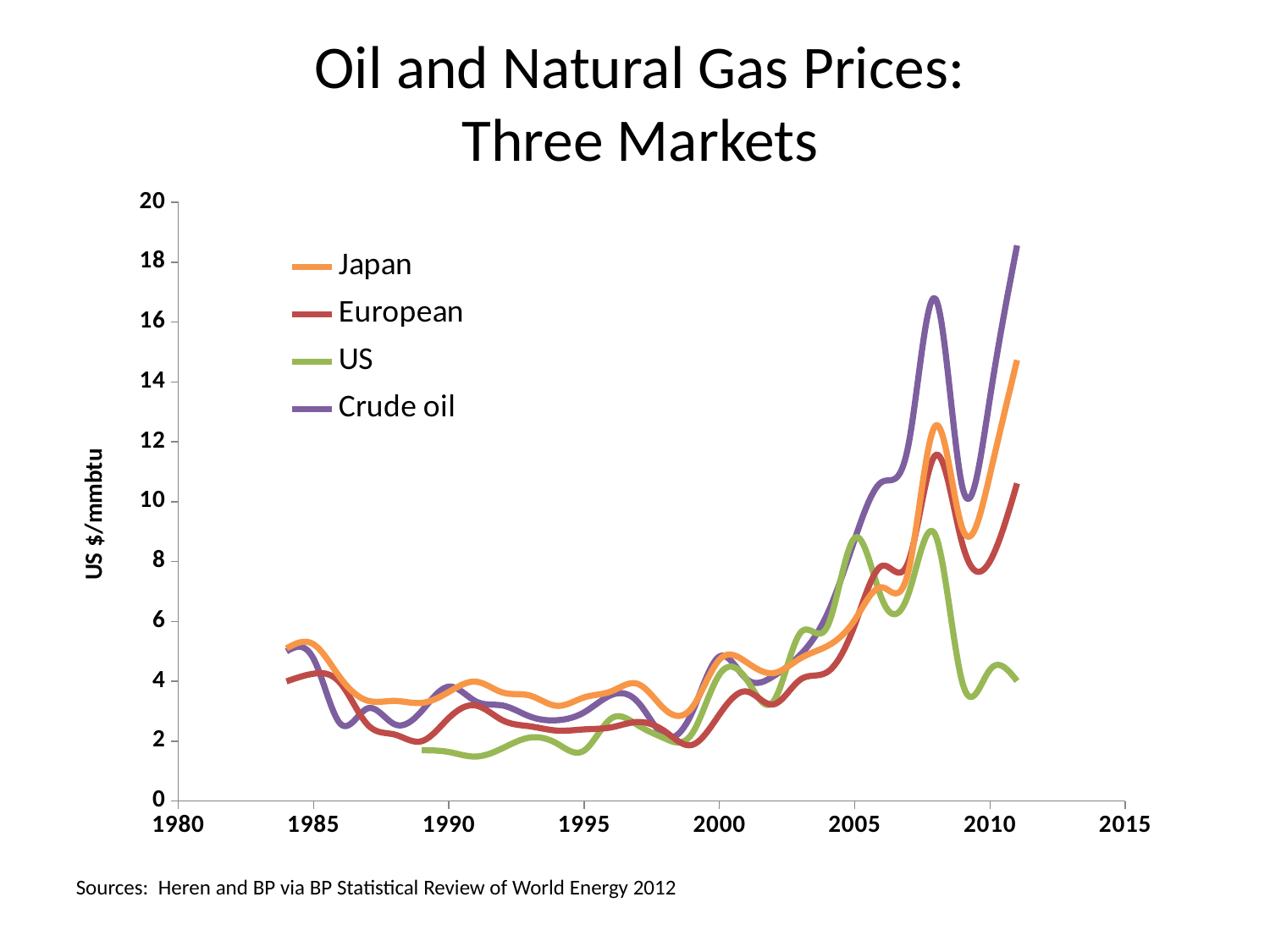
What is the title of the chart? Oil and Natural Gas Prices: Three Markets Is the value for Crude oil in 2011 greater or less than 16? greater What kind of chart is shown on the slide? line chart How many series does the legend list? 4 Is the value for US in 2011 greater or less than 6? less Does the Crude oil series rise or fall between 2009 and 2011? rise Which series has the lowest value at the right end of the chart (2011)? US What is the label on the vertical axis? US $/mmbtu Is the value for European in 2011 greater or less than 8? greater In 2011, which is larger, the Japan value or the European value? Japan Which series reaches the highest value on the chart? Crude oil